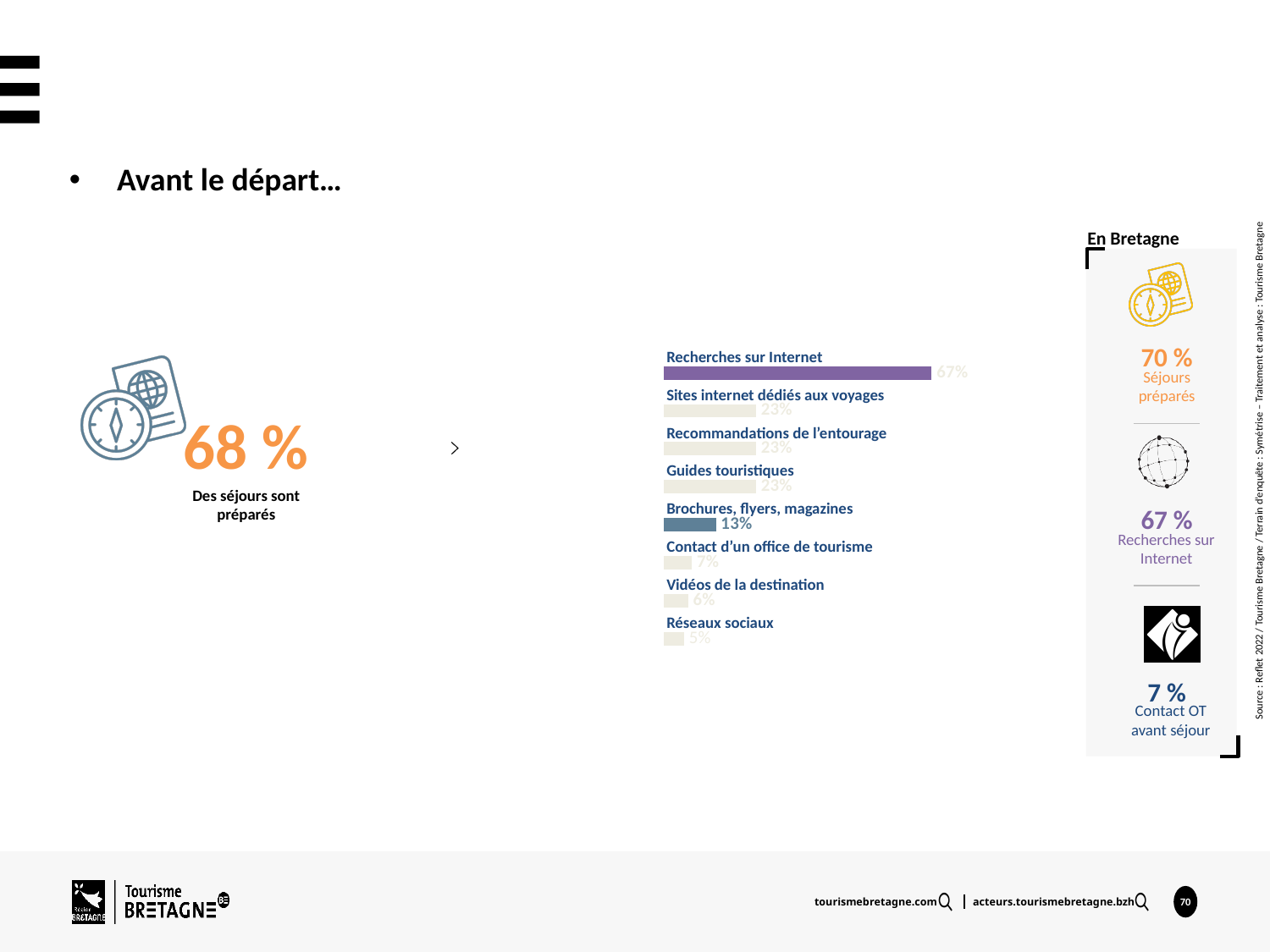
Which is larger in the bar chart: Contact d'un office de tourisme or Vidéos de la destination? Contact d'un office de tourisme Which category has the lowest value in the bar chart? Réseaux sociaux Which category has the highest value in the bar chart? Recherches sur Internet What is the value for Brochures, flyers, magazines in the bar chart? 13% What is the difference between the values for Recherches sur Internet and Guides touristiques? 44% What is the value for Réseaux sociaux in the bar chart? 5% What is the value for Recherches sur Internet in the bar chart? 67% What is the value for Sites internet dédiés aux voyages in the bar chart? 23% How many categories are shown in the bar chart? 8 What is the difference between the values for Brochures, flyers, magazines and Vidéos de la destination? 7% What kind of chart is shown on the slide? Bar chart What is the value for Contact d'un office de tourisme in the bar chart? 7%